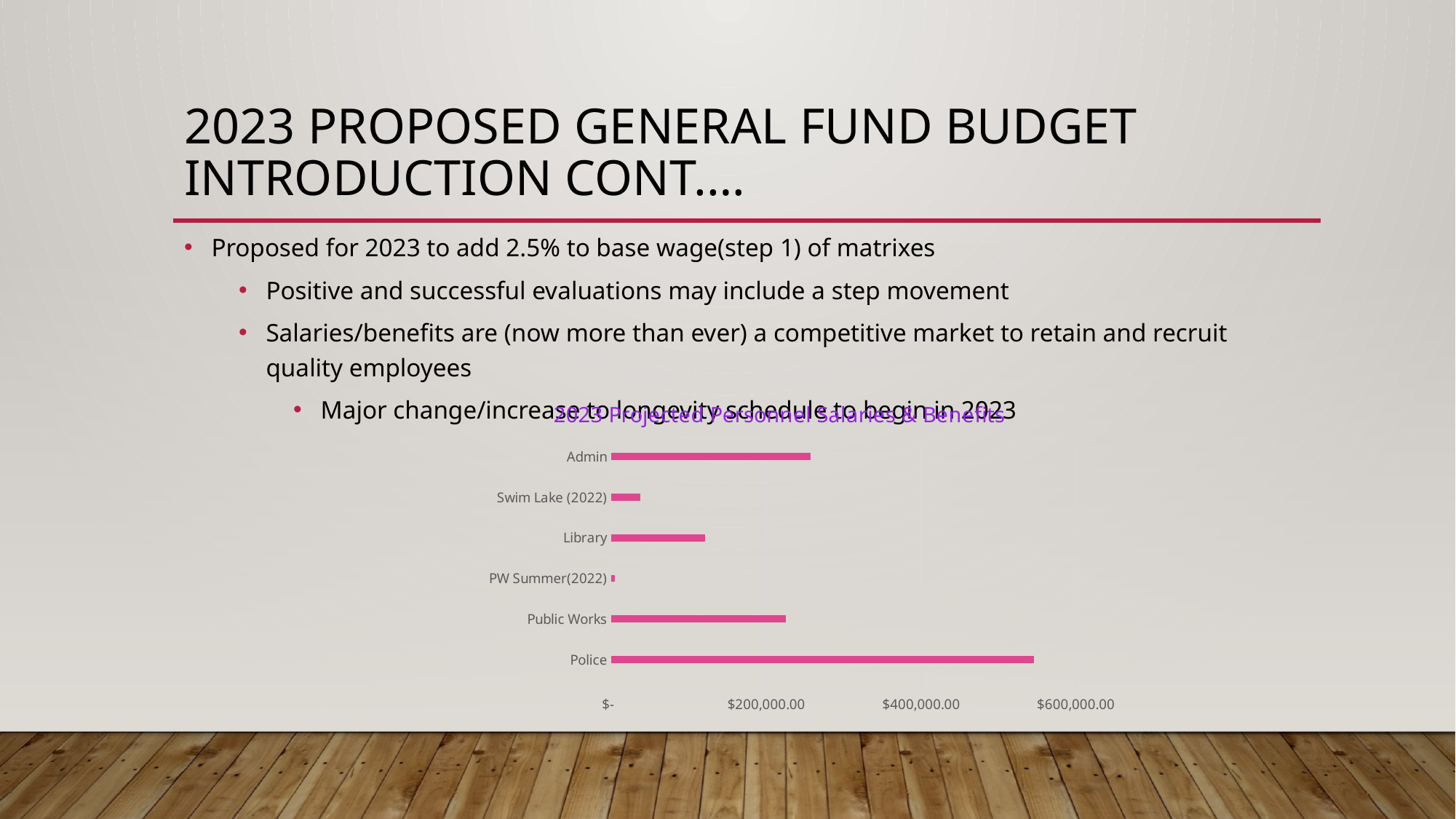
What kind of chart is shown on the slide? Bar chart Is the value for Admin greater or less than $200,000.00? greater Which is larger, the value for Library or the value for Swim Lake (2022)? Library Which category has the highest projected salaries and benefits? Police Which category has the lowest projected salaries and benefits? PW Summer(2022) Which is larger, the value for Public Works or the value for PW Summer(2022)? Public Works Is the value for Police greater or less than $600,000.00? less Is the value for Swim Lake (2022) greater or less than $200,000.00? less How many categories are plotted in the chart? 6 What is the title of the chart? 2023 Projected Personnel Salaries & Benefits